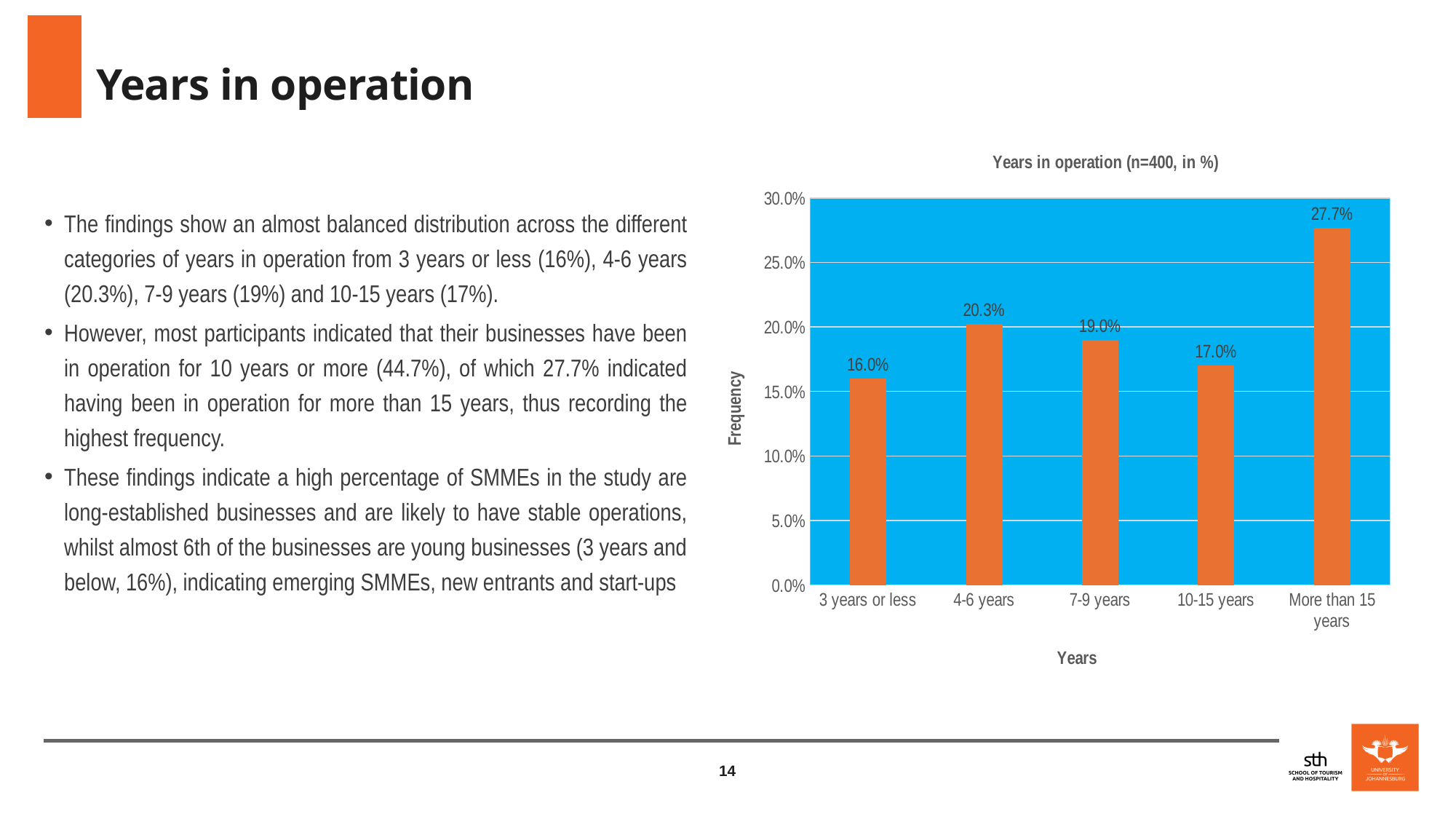
Which category has the lowest value? 3 years or less Which is larger, the value for 4-6 years or the value for 7-9 years? 4-6 years What is the value for 4-6 years? 20.3% What is the label of the y axis? Frequency What is the difference between the values for More than 15 years and 10-15 years? 10.7% What is the value for 3 years or less? 16.0% Is the value for 10-15 years greater or less than 20.0%? less What is the title of the chart? Years in operation (n=400, in %) How many categories are shown on the x axis? 5 What kind of chart is shown? bar chart What is the value for More than 15 years? 27.7% Which category has the highest value? More than 15 years